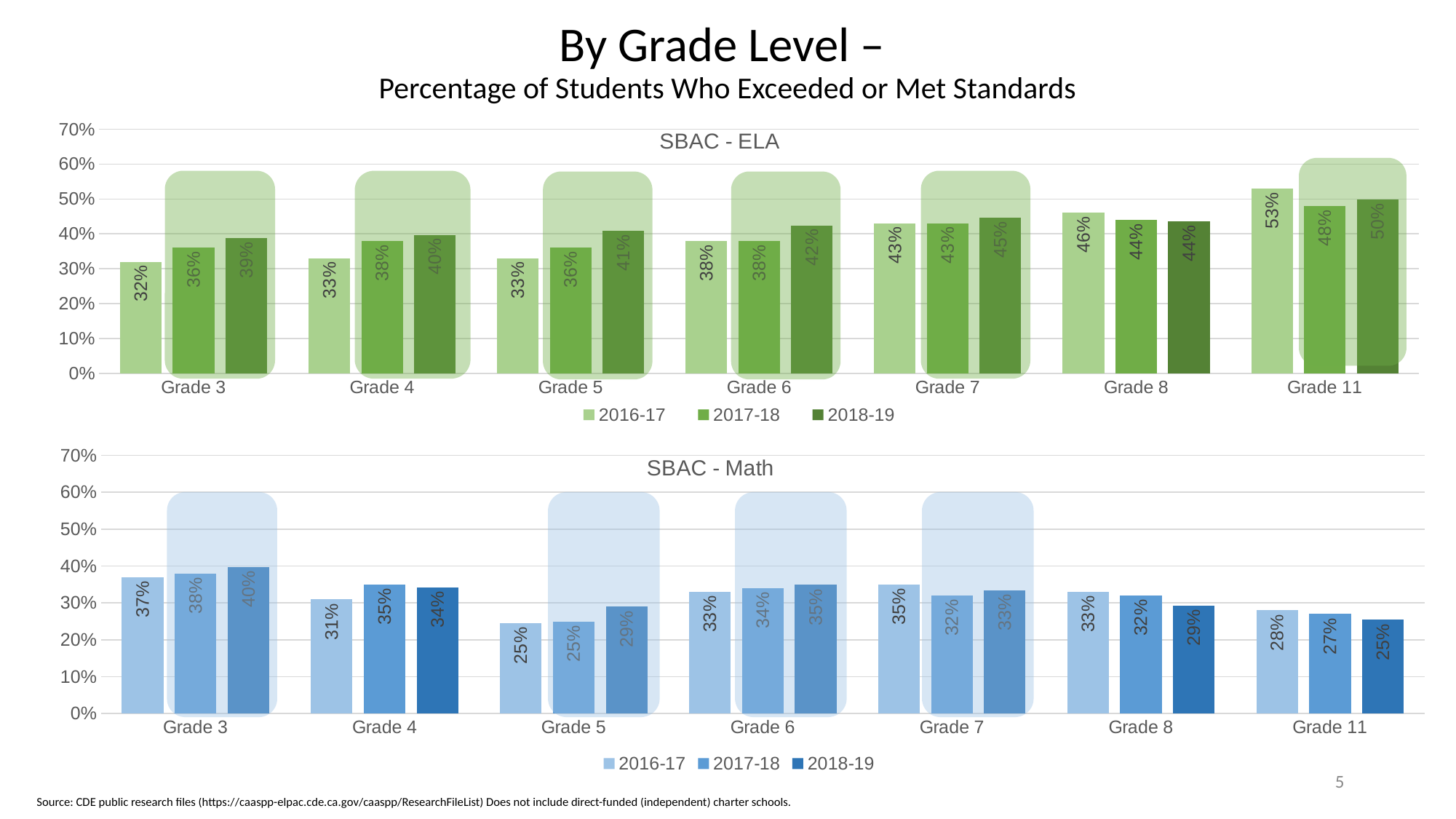
In the SBAC - ELA chart, what is the value for Grade 11 in 2016-17? 53% How many grade levels are shown in the SBAC - Math chart? 7 In the SBAC - Math chart, what is the difference between the 2016-17 and 2018-19 values for Grade 8? 4% In the SBAC - Math chart, which is larger for Grade 4: the 2017-18 value or the 2018-19 value? 2017-18 How many series does the legend of the SBAC - ELA chart list? 3 In the SBAC - ELA chart, is the value for Grade 8 in 2016-17 greater or less than 40%? greater In the SBAC - Math chart, do the values for Grade 11 rise or fall from 2016-17 to 2018-19? Fall In the SBAC - Math chart, which grade has the lowest value for 2016-17? Grade 5 In the SBAC - ELA chart, what is the difference between the 2018-19 and 2016-17 values for Grade 5? 8% In the SBAC - ELA chart, which grade has the highest value for 2018-19? Grade 11 What kind of chart is the SBAC - Math chart? Bar chart In the SBAC - Math chart, what is the value for Grade 5 in 2018-19? 29%